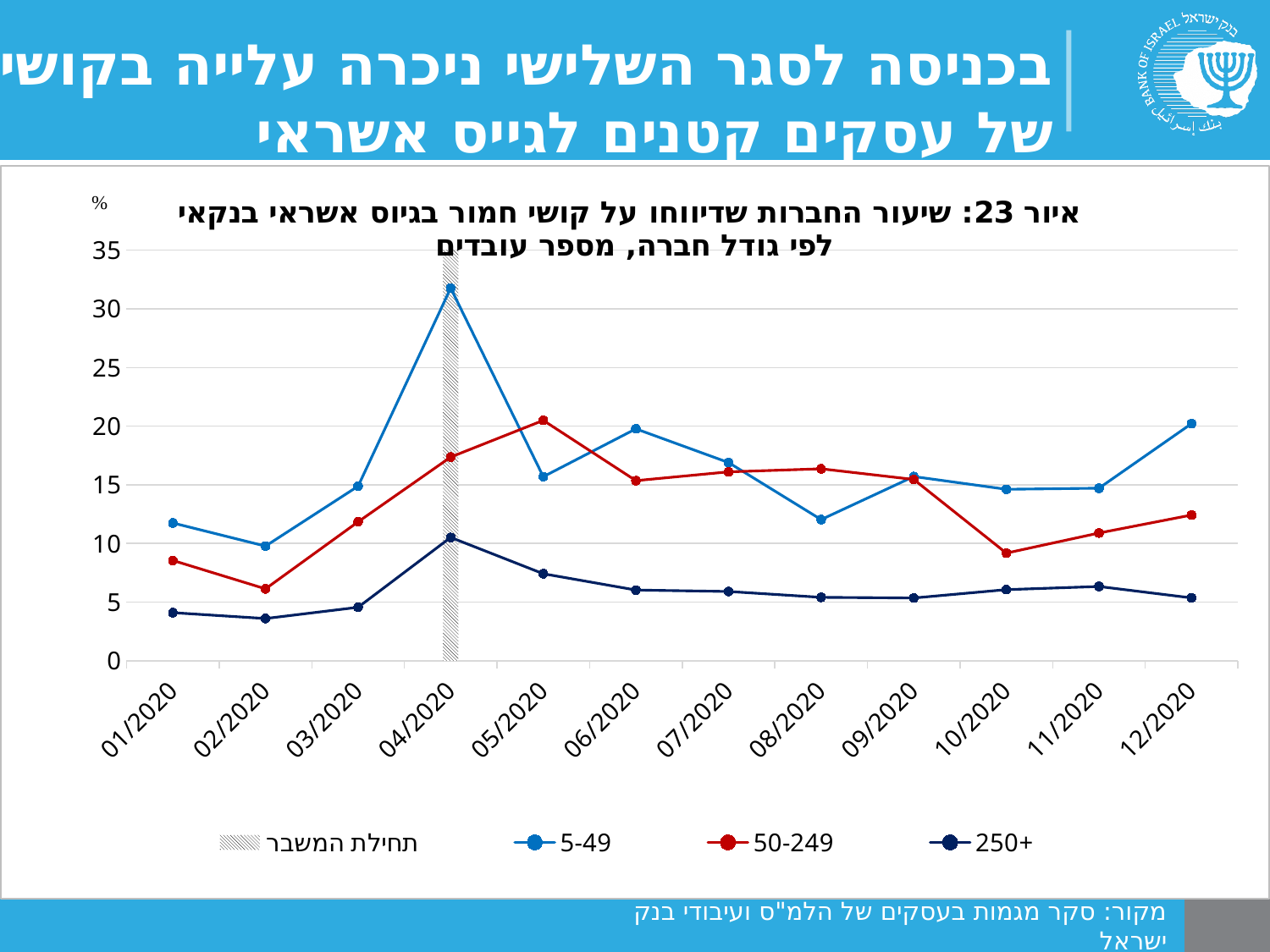
What kind of chart is shown on the slide? line chart Is the value for the 250+ series in 02/2020 greater or less than 5? less How many months are shown along the x axis of the chart? 12 How many data series (lines) are plotted in the chart? 3 Is the value for the 5-49 series in 04/2020 greater or less than 30? greater Which series has the lowest values across all months of 2020? 250+ In which month does the 5-49 series reach its highest value? 04/2020 Which month is marked with the shaded area labelled תחילת המשבר? 04/2020 Is the value for the 5-49 series in 08/2020 greater or less than 15? less Does the 250+ series rise or fall from 04/2020 to 08/2020? fall In 05/2020, which series has the larger value, 5-49 or 50-249? 50-249